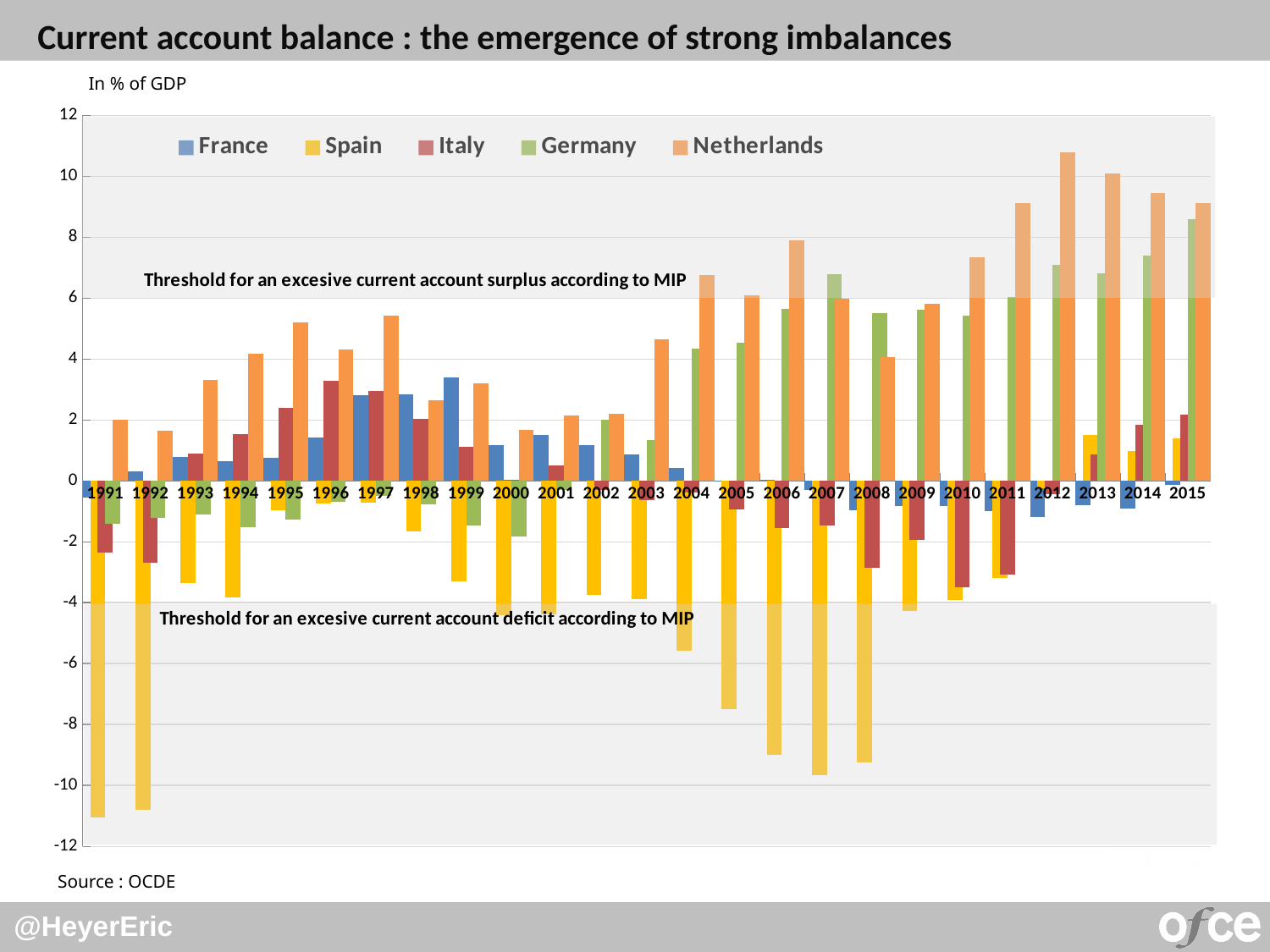
Is the value for Germany in 2015 greater or less than 8? greater How many series does the legend list? 5 Is the value for the Netherlands in 2012 greater or less than 10? greater In what unit are the values on the chart expressed? In % of GDP Do the values for the Netherlands rise or fall from 2012 to 2015? fall How many years are shown along the x axis? 25 In which year does the Netherlands reach its highest value? 2012 What is the title of the chart? Current account balance : the emergence of strong imbalances In 2007, which is larger: the value for Germany or the value for the Netherlands? Germany Which country has the lowest value in 2007? Spain Is the value for Spain in 1991 greater or less than -10? less What kind of chart is shown on the slide? bar chart